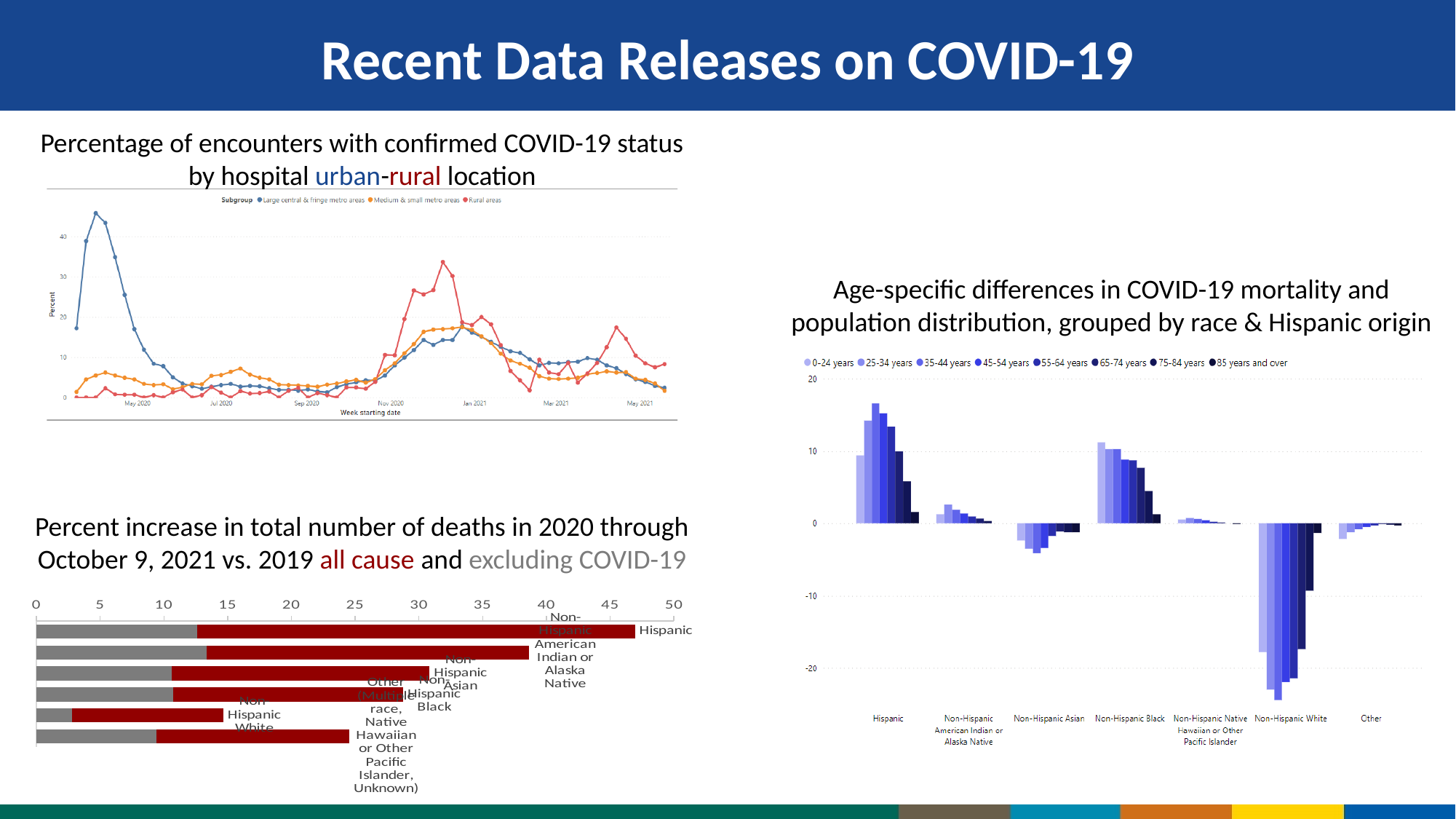
In the bottom-left chart on percent increase in total number of deaths, is the total bar for Non-Hispanic White greater or less than 20? less In the top-left chart on percentage of encounters with confirmed COVID-19 status, is the peak value of the 'Large central & fringe metro areas' line greater or less than 40? greater In the top-left chart on percentage of encounters with confirmed COVID-19 status, how many subgroups does the legend list? 3 In the right-hand chart on age-specific differences in COVID-19 mortality and population distribution, how many age groups does the legend list? 8 In the bottom-left chart on percent increase in total number of deaths, is the total bar for Hispanic greater or less than 45? greater What kind of chart is the top-left chart titled 'Percentage of encounters with confirmed COVID-19 status by hospital urban-rural location'? Line chart What kind of chart is the bottom-left chart on percent increase in total number of deaths in 2020 through October 9, 2021 vs. 2019? Bar chart In the bottom-left chart on percent increase in total number of deaths, which group has the shortest total bar? Non-Hispanic White In the right-hand chart on age-specific differences in COVID-19 mortality and population distribution, which race/Hispanic origin group has the most negative bars? Non-Hispanic White In the top-left chart on percentage of encounters with confirmed COVID-19 status, what is the label of the x axis? Week starting date In the bottom-left chart on percent increase in total number of deaths, which group has the longest total bar? Hispanic